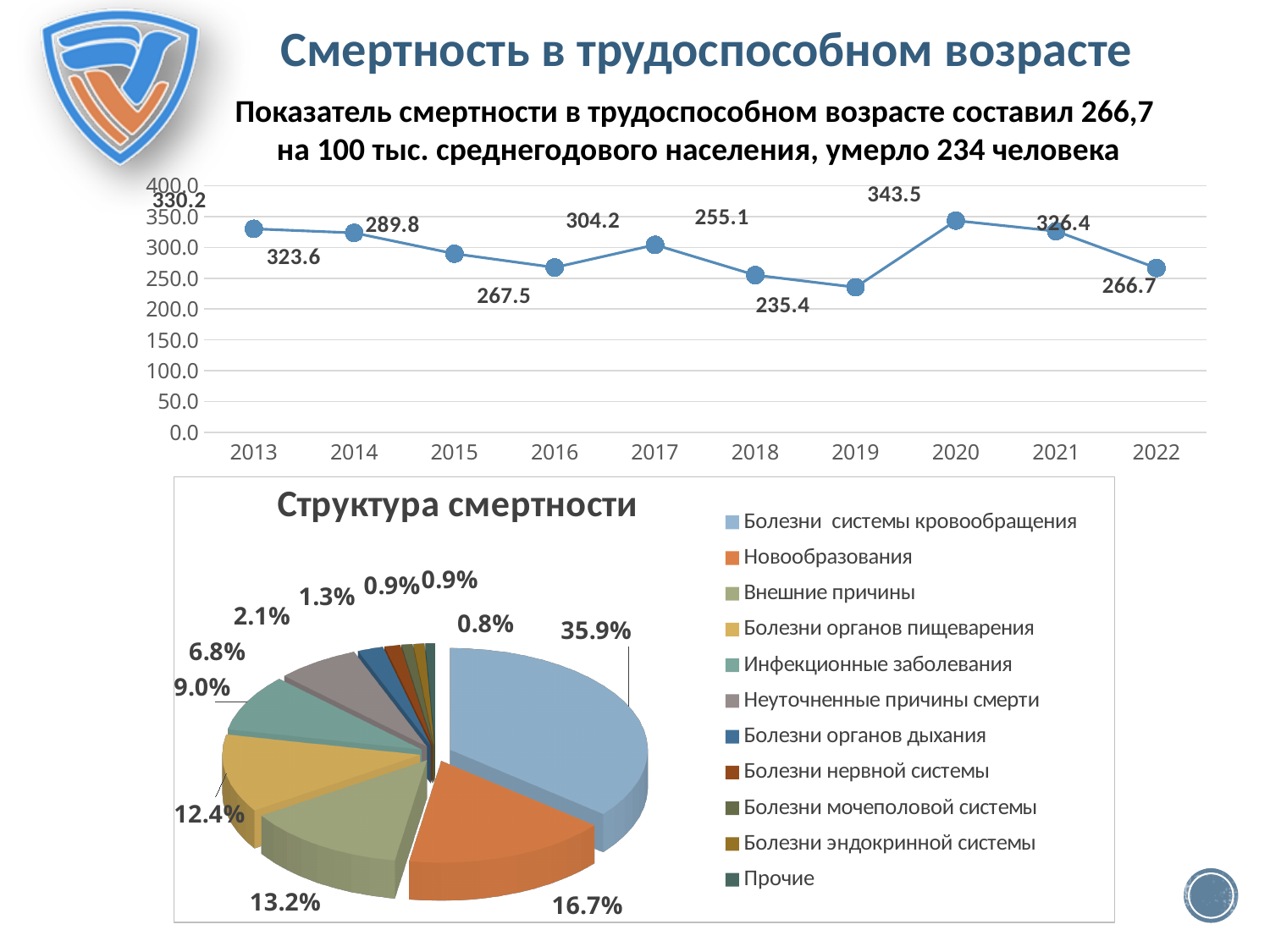
On the pie chart 'Структура смертности', which category has the largest share? Болезни системы кровообращения On the top line chart, what is the value for 2020? 343.5 What type of chart is the top chart on the slide? line chart On the top line chart, which year has the highest value? 2020 On the pie chart 'Структура смертности', what share is Новообразования? 16.7% On the top line chart, what is the difference between the values for 2013 and 2022? 63.5 On the top line chart, what is the value for 2019? 235.4 On the top line chart, do the values rise or fall from 2020 to 2022? fall On the pie chart 'Структура смертности', how many categories does the legend list? 11 On the top line chart, which is larger, the value for 2017 or the value for 2018? 2017 On the top line chart, how many years are plotted? 10 On the top line chart, which year has the lowest value? 2019